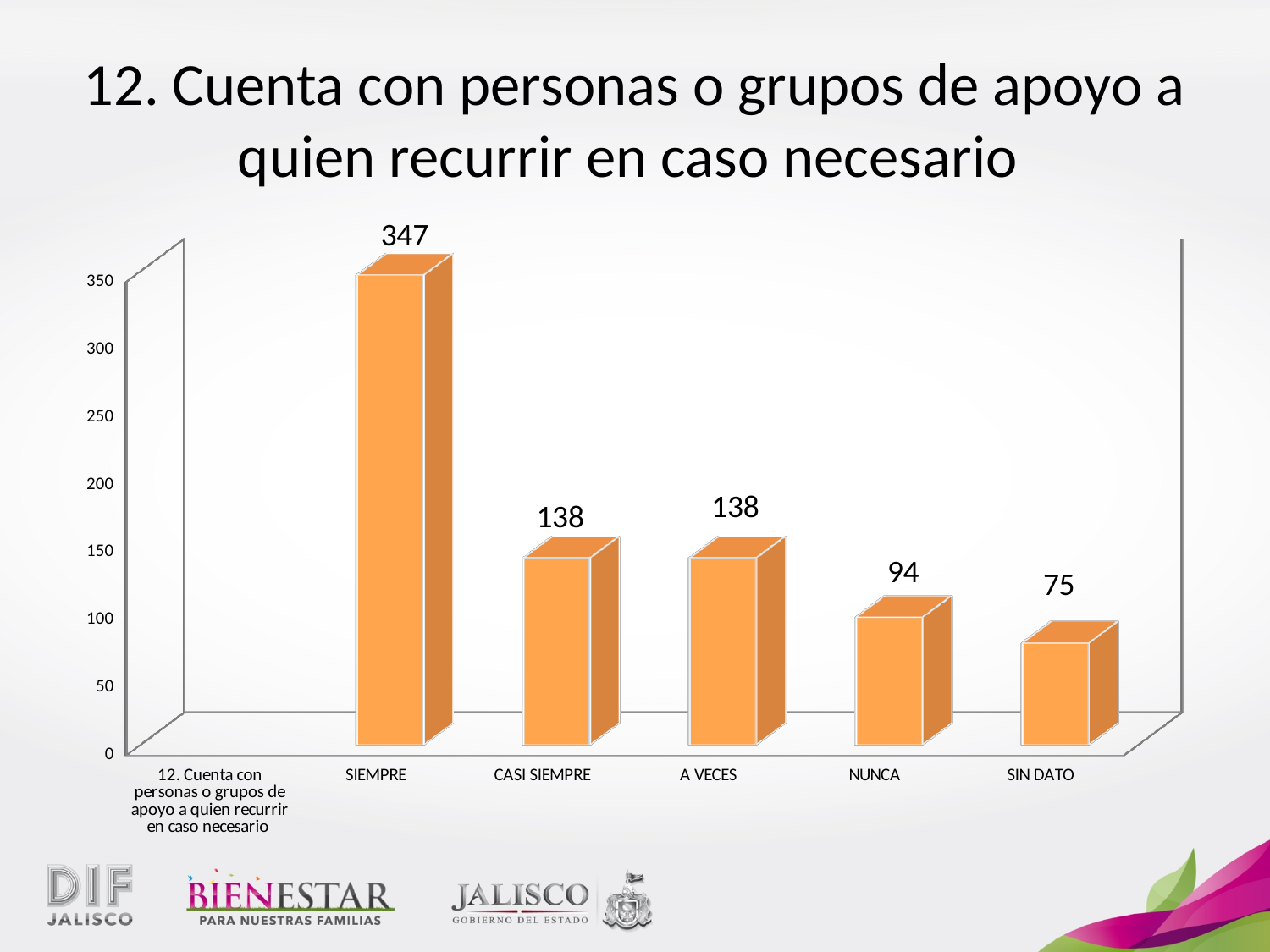
What is the value for SIN DATO? 75 What is the difference between the values for NUNCA and SIN DATO? 19 Is the value for SIEMPRE greater or less than 300? greater Which category has the highest value? SIEMPRE How many bars are plotted in the chart? 5 What is the value for SIEMPRE? 347 What is the value for NUNCA? 94 Which category has the lowest value? SIN DATO What kind of chart is shown on the slide? bar chart What is the difference between the values for SIEMPRE and CASI SIEMPRE? 209 Do the values generally rise or fall from left to right across the bars? fall Which is larger, the value for NUNCA or the value for SIN DATO? NUNCA